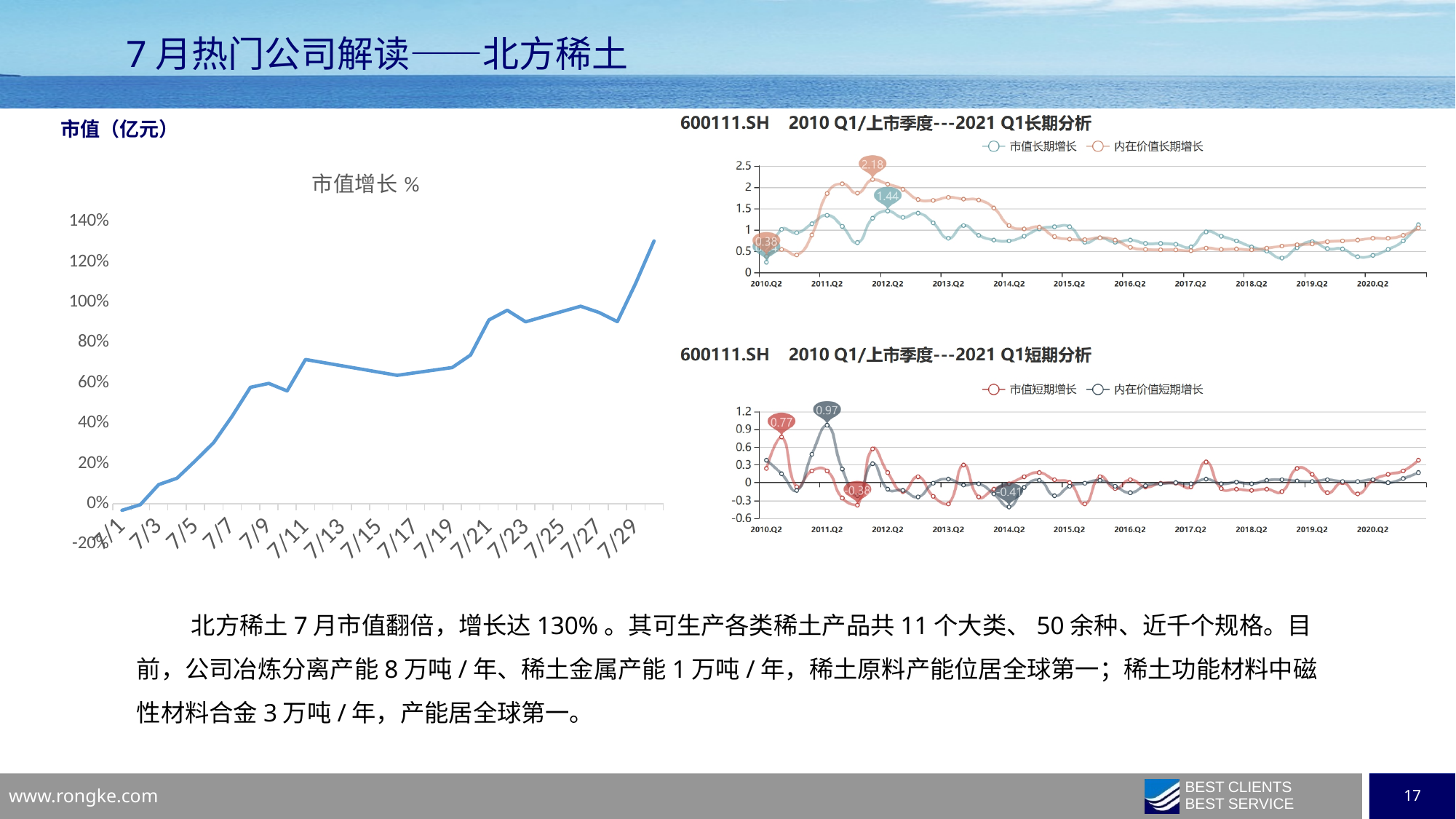
In the left chart titled 市值增长 %, is the value at 7/11 greater or less than 60%? greater In the bottom-right chart (短期分析), what is the lowest labeled value shown? -0.41 In the left chart titled 市值增长 %, do the values generally rise or fall from 7/1 to the end of the month? rise In the bottom-right chart (短期分析), what is the labeled peak value of the 市值短期增长 series? 0.77 In the left chart titled 市值增长 %, is the final plotted value greater or less than 120%? greater In the top-right chart (长期分析), what is the difference between the labeled peaks 2.18 and 1.44? 0.74 How many series does the legend of the top-right chart (长期分析) list? 2 What kind of chart is the left chart titled 市值增长 %? line chart In the top-right chart (长期分析), what is the labeled peak value of the 内在价值长期增长 series? 2.18 In the top-right chart (长期分析), which series has the higher labeled peak, 市值长期增长 or 内在价值长期增长? 内在价值长期增长 In the top-right chart (长期分析), what is the labeled peak value of the 市值长期增长 series? 1.44 In the bottom-right chart (短期分析), what is the labeled peak value of the 内在价值短期增长 series? 0.97